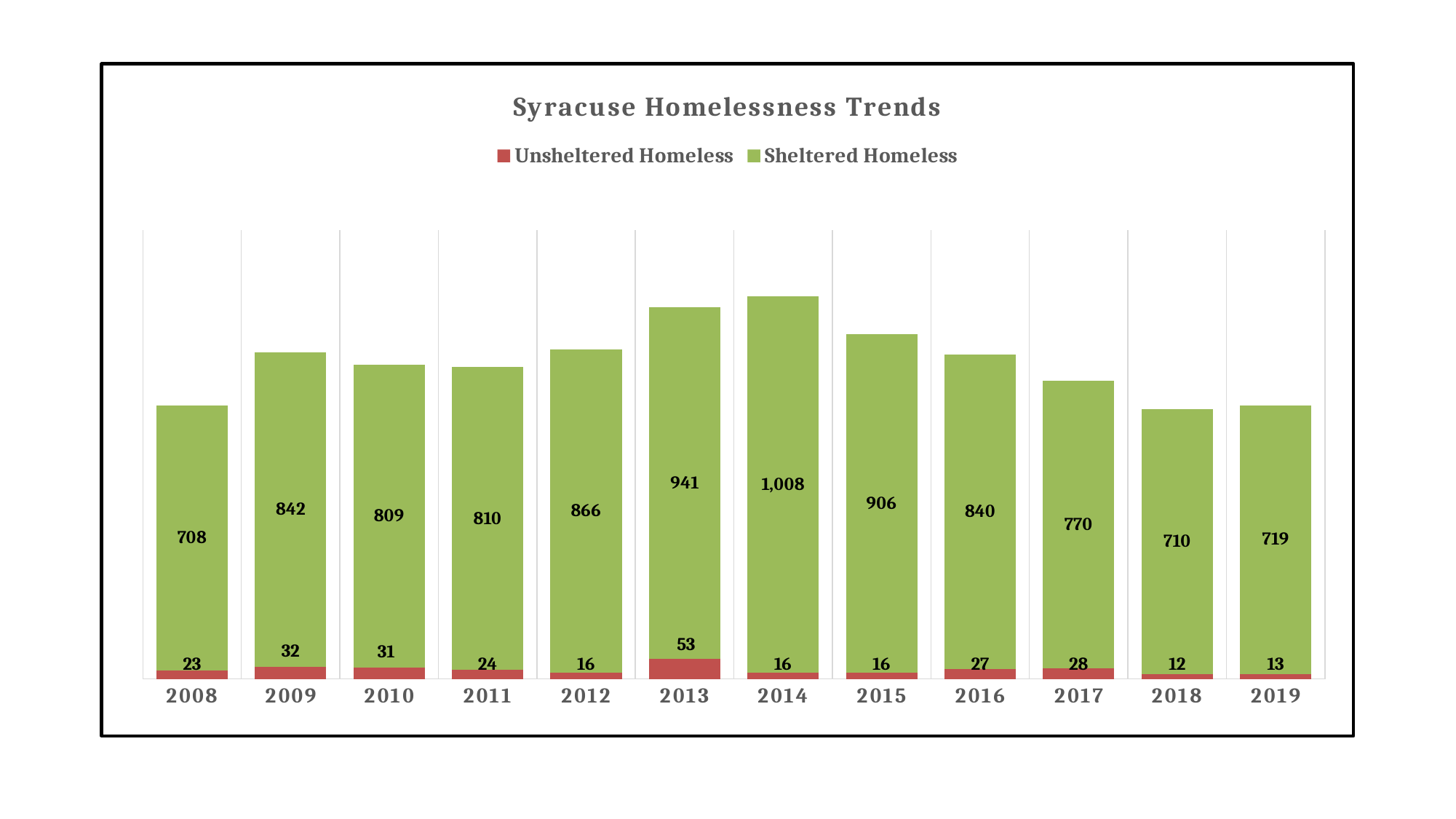
How many years are shown on the x axis? 12 Which year has the lowest Unsheltered Homeless value? 2018 What is the Unsheltered Homeless value for 2013? 53 Which is larger, the Unsheltered Homeless value for 2009 or for 2017? 2009 Do the Sheltered Homeless values rise or fall from 2014 to 2018? Fall Which year has the highest Sheltered Homeless value? 2014 What kind of chart is shown on the slide? Stacked bar chart What is the difference between the Sheltered Homeless values for 2014 and 2008? 300 What is the total of the stacked bar for 2013? 994 What is the Sheltered Homeless value for 2014? 1,008 How many series does the legend list? 2 What is the title of the chart? Syracuse Homelessness Trends